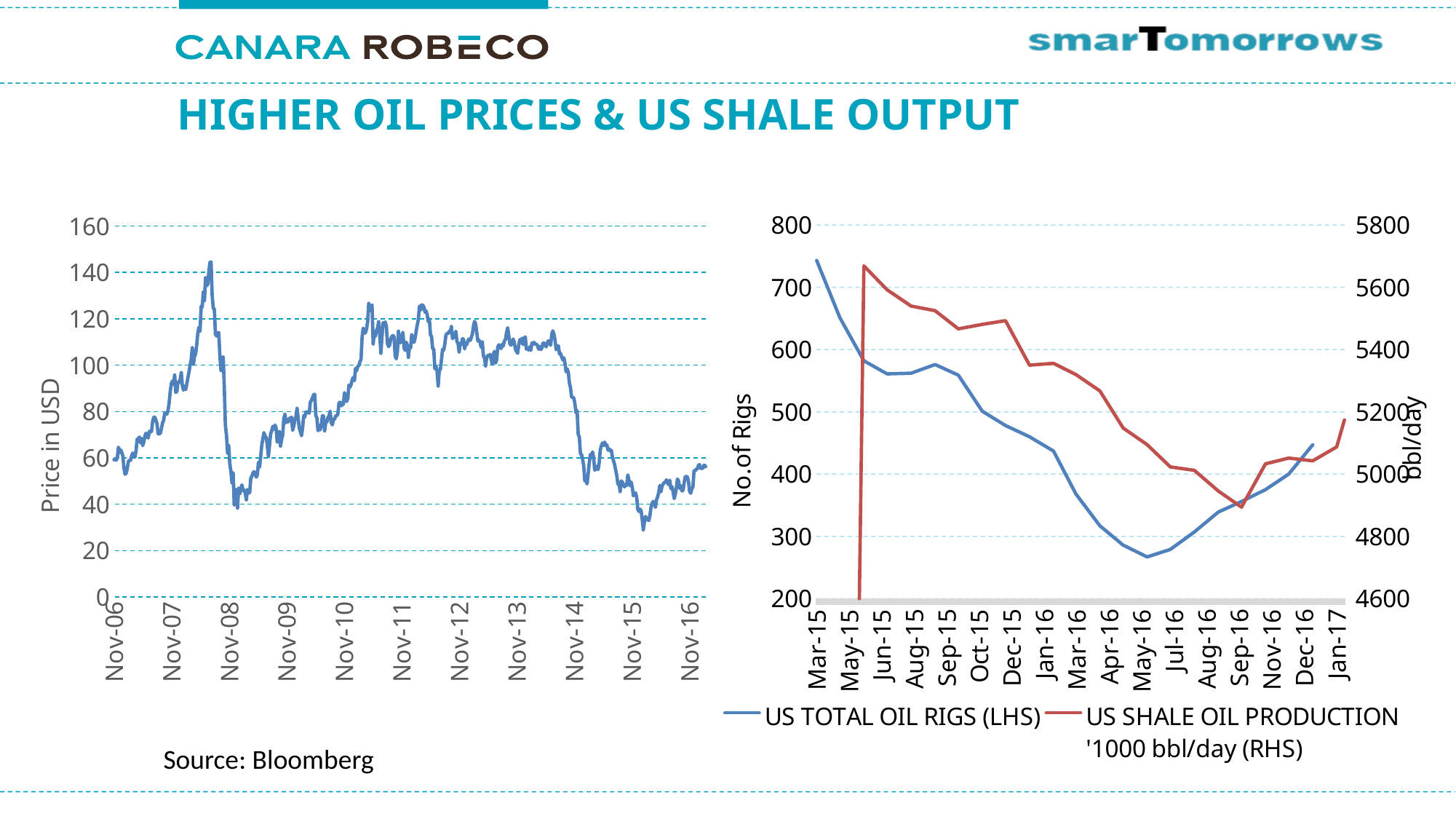
In the left chart, is the price at Nov-12 greater or less than 100? greater In the right chart, is the value for US Total Oil Rigs at May-16 greater or less than 300? less In the left chart, is the peak price reached around 2008 greater or less than 140? greater What kind of chart is the right chart (US Total Oil Rigs and US Shale Oil Production)? line chart How many series does the legend of the right chart list? 2 In the right chart, does US Total Oil Rigs rise or fall from Mar-15 to May-16? fall In the right chart, at which month is US Total Oil Rigs lowest? May-16 What is the y-axis label of the left chart? Price in USD What kind of chart is the left chart (Price in USD)? line chart